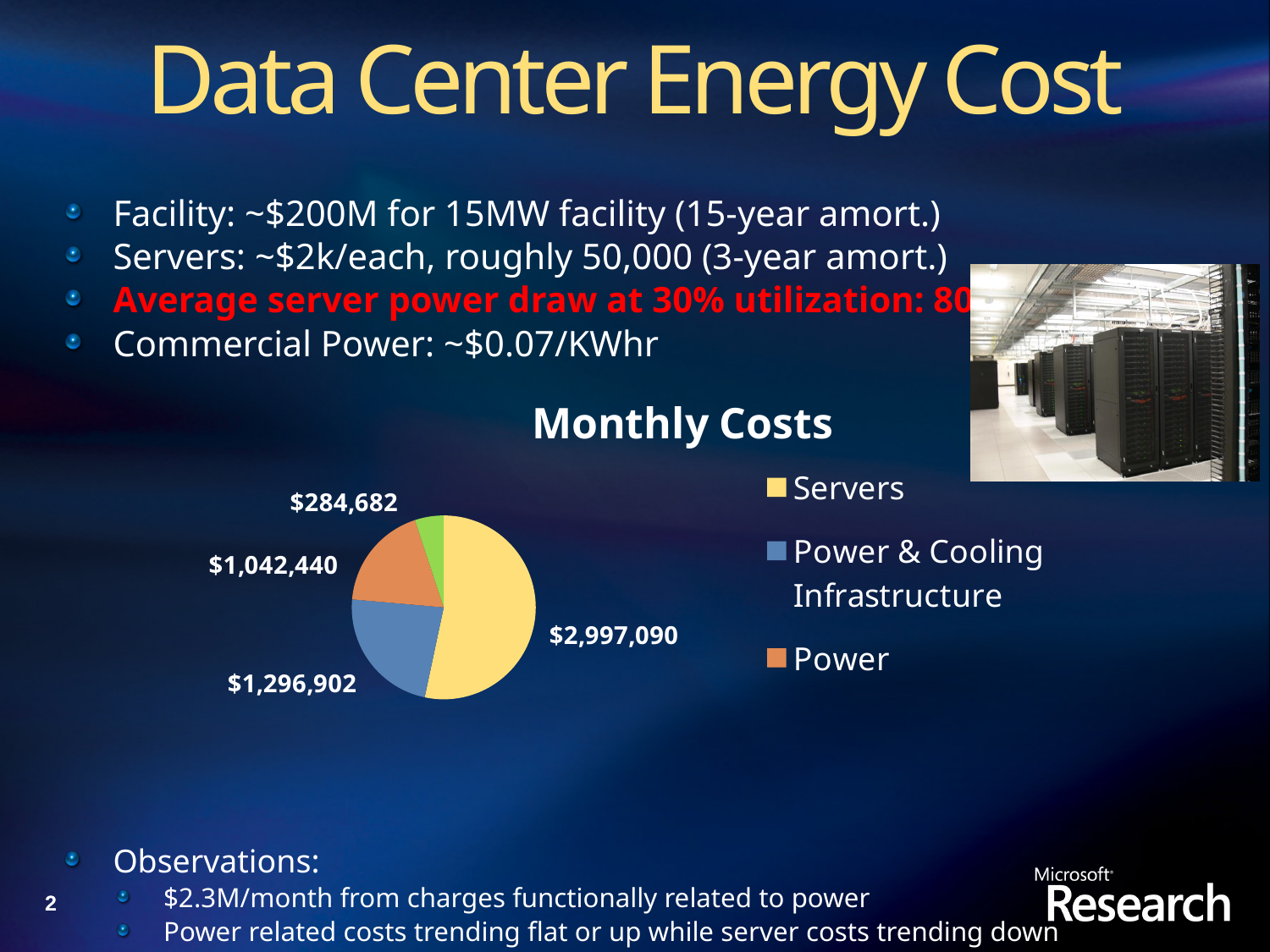
In the Monthly Costs pie chart, what is the value for Servers? $2,997,090 In the Monthly Costs pie chart, what is the value for Power? $1,042,440 How many entries does the legend of the Monthly Costs chart list? 3 In the Monthly Costs pie chart, which is larger: Servers or Power? Servers What is the title of the chart on the slide? Monthly Costs In the Monthly Costs pie chart, what is the difference between the Power & Cooling Infrastructure value and the Power value? $254,462 What type of chart is shown under the title "Monthly Costs"? Pie chart In the Monthly Costs pie chart, which is larger: Power & Cooling Infrastructure or Power? Power & Cooling Infrastructure In the Monthly Costs pie chart, what is the value for Power & Cooling Infrastructure? $1,296,902 In the Monthly Costs pie chart, what is the difference between the Servers value and the Power & Cooling Infrastructure value? $1,700,188 How many slices does the Monthly Costs pie chart have? 4 Which category has the largest slice in the Monthly Costs pie chart? Servers